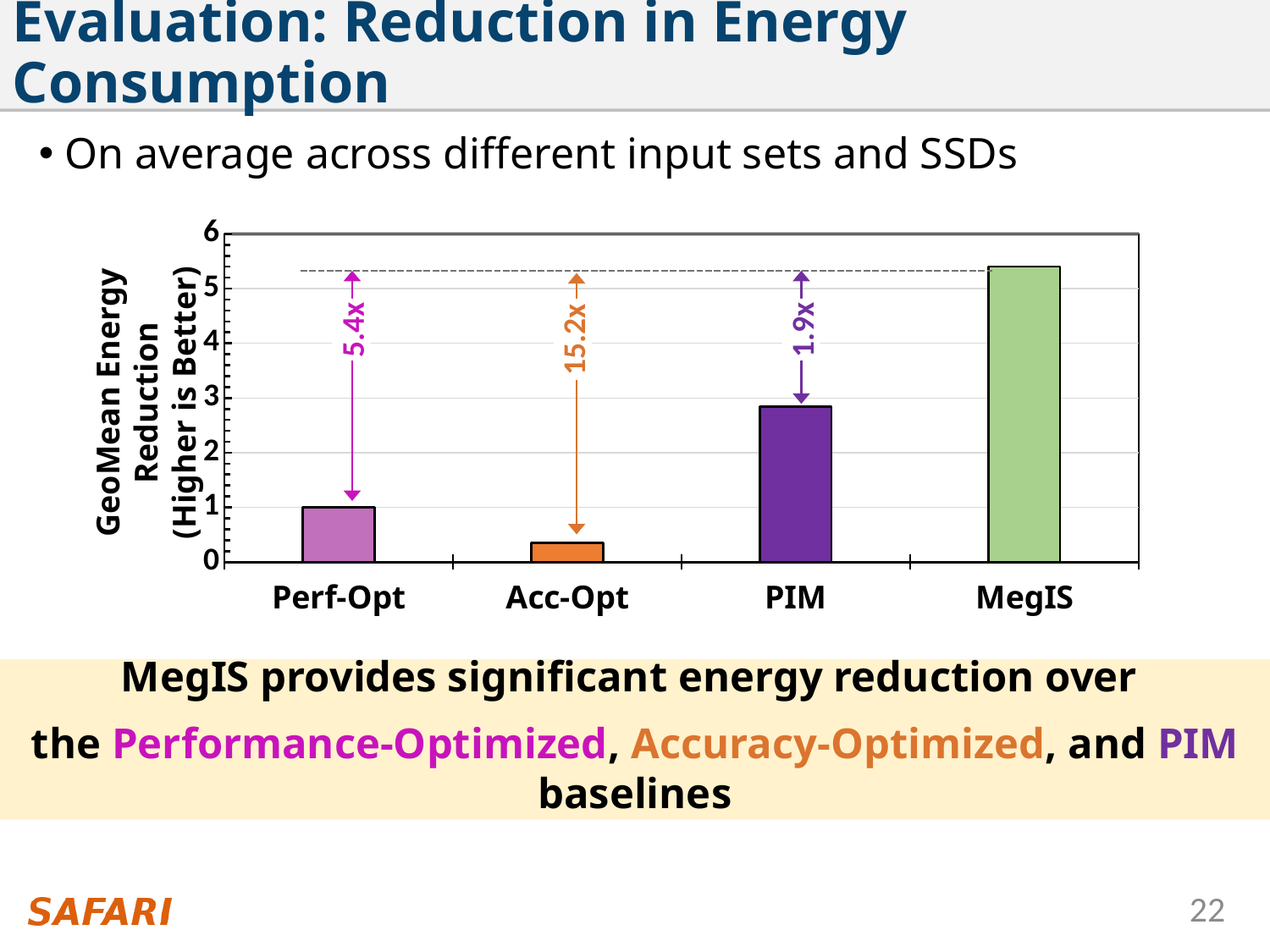
Is the value for MegIS greater or less than 5? greater Is the value for PIM greater or less than 3? less What kind of chart is shown on the slide? bar chart Which category has the highest GeoMean Energy Reduction? MegIS What improvement factor is annotated above the Acc-Opt bar? 15.2x What is the label of the y axis of the chart? GeoMean Energy Reduction (Higher is Better) Which has a larger GeoMean Energy Reduction, PIM or Perf-Opt? PIM Is the value for PIM greater or less than 2? greater How many categories are shown on the x axis of the chart? 4 What improvement factor is annotated above the PIM bar? 1.9x Which category has the lowest GeoMean Energy Reduction? Acc-Opt